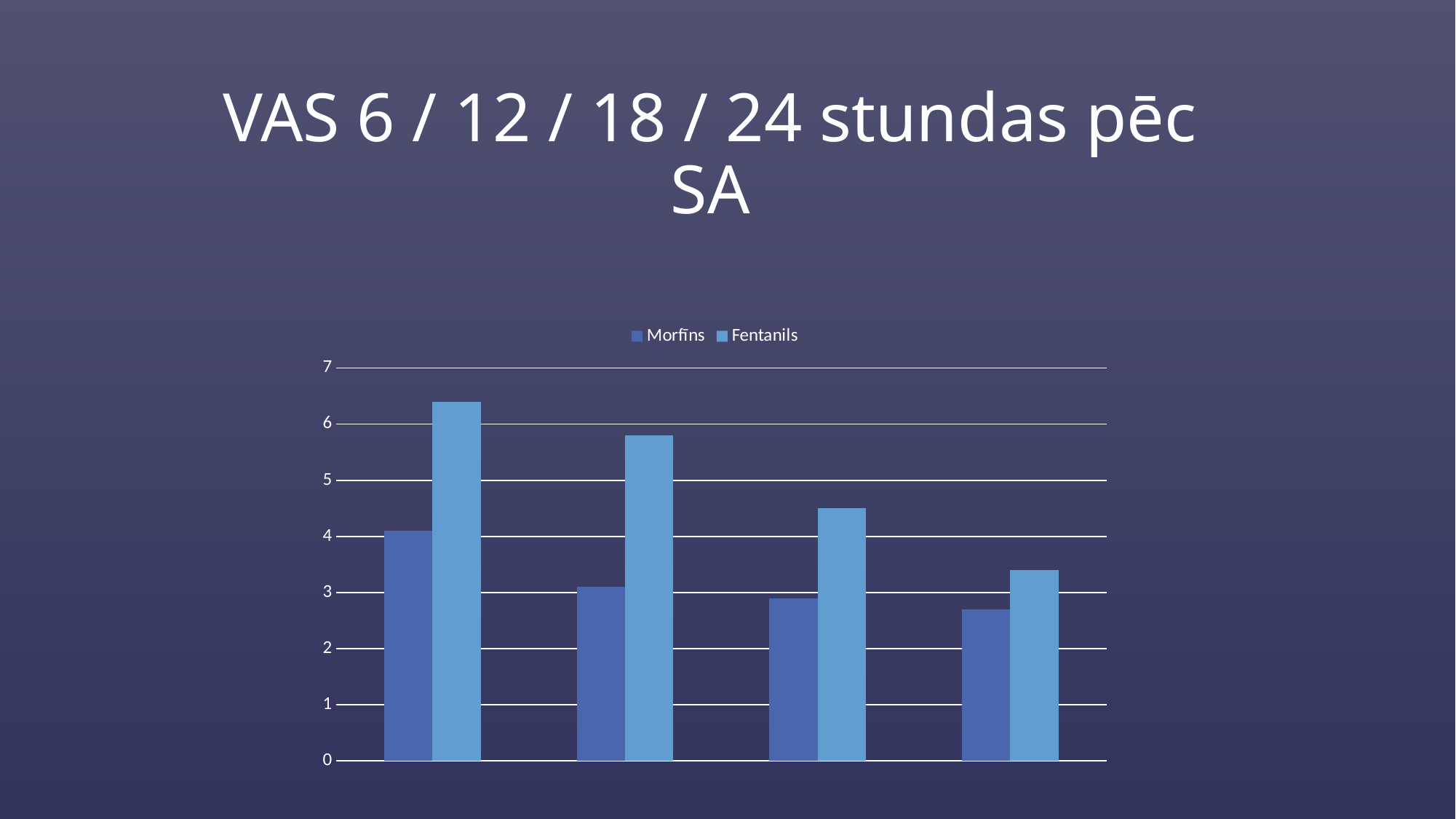
Do the Fentanils values rise or fall from left to right across the groups? fall Is the Fentanils value in the third group of bars greater or less than 5? less What is the title of the slide containing the chart? VAS 6 / 12 / 18 / 24 stundas pēc SA How many groups of bars are plotted in the chart? 4 How many series does the chart legend list? 2 In the first group of bars, which series has the larger value, Morfīns or Fentanils? Fentanils Is the Morfīns value in the fourth group of bars greater or less than 3? less In which group of bars is the Fentanils value highest? the first group What kind of chart is shown on the slide? bar chart What are the two series named in the chart legend? Morfīns and Fentanils Is the Fentanils value in the second group of bars greater or less than 5? greater